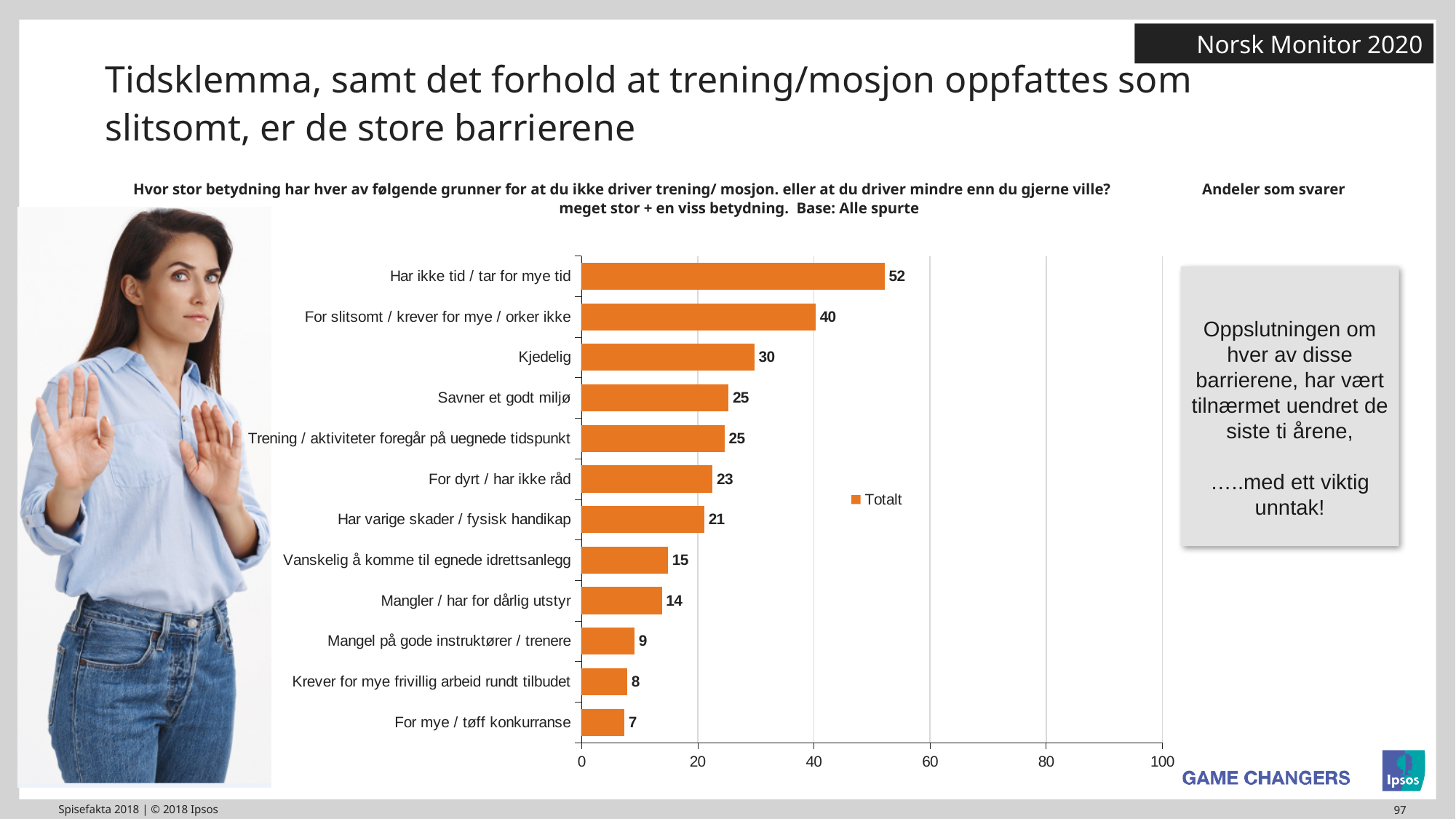
What is the name of the series shown in the legend? Totalt What is the difference between "Har ikke tid / tar for mye tid" and "For slitsomt / krever for mye / orker ikke"? 12 What kind of chart is shown on the slide? Bar chart Which category has the lowest value? For mye / tøff konkurranse How many categories are shown in the chart? 12 Which is larger: "Har varige skader / fysisk handikap" or "Vanskelig å komme til egnede idrettsanlegg"? Har varige skader / fysisk handikap What is the value for "Har ikke tid / tar for mye tid"? 52 What is the value for "For dyrt / har ikke råd"? 23 How many series does the legend list? 1 Which category has the highest value? Har ikke tid / tar for mye tid What is the value for "Kjedelig"? 30 Is the value for "For slitsomt / krever for mye / orker ikke" greater or less than 20? greater